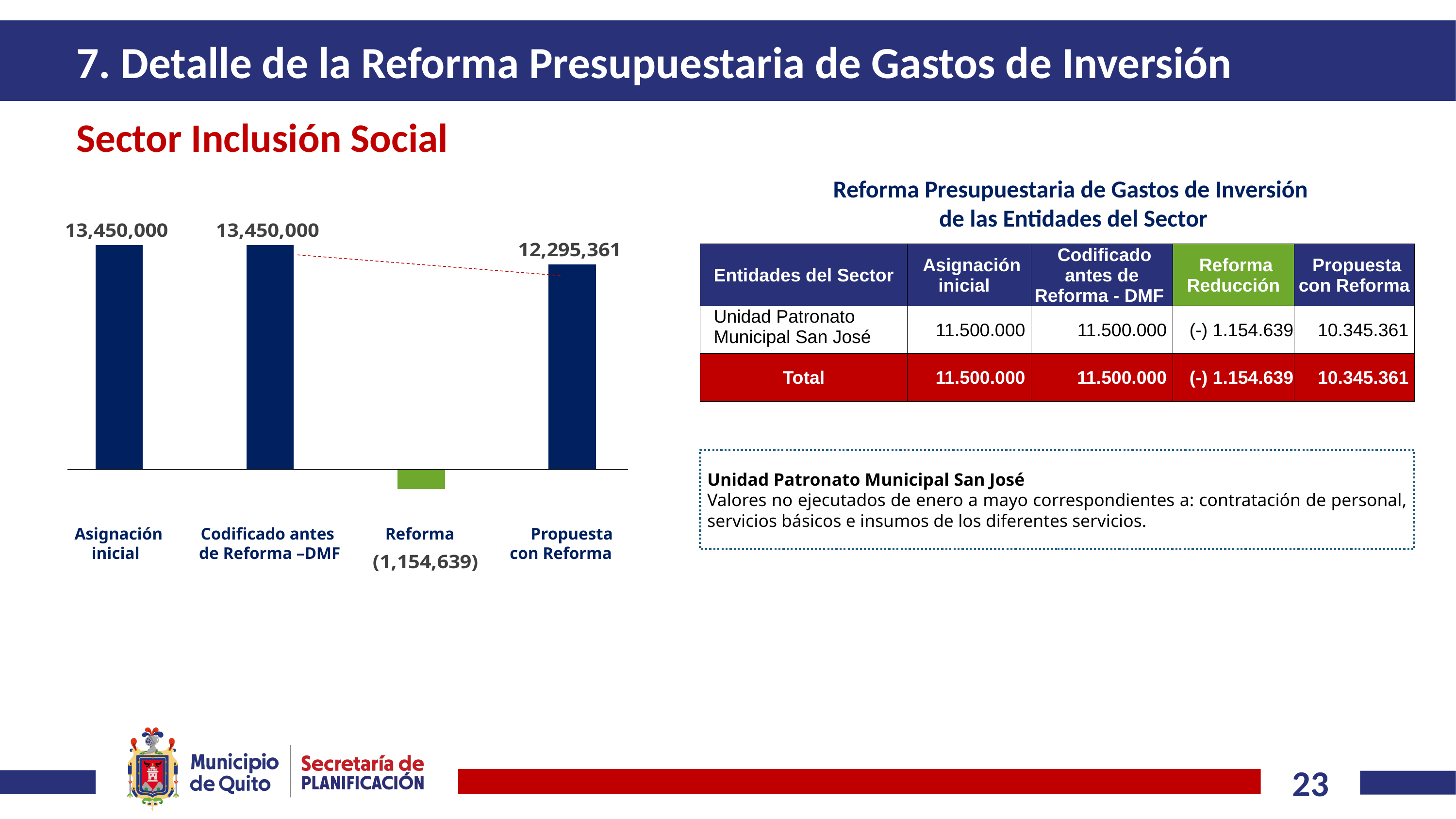
How many categories are plotted in the chart? 4 What value is labelled for the Reforma bar in the chart? (1,154,639) Which bar in the chart is coloured green? Reforma Which category has the lowest value in the chart? Reforma Which sector heading appears above the chart? Sector Inclusión Social What is the value of the Asignación inicial bar in the chart? 13,450,000 Does the value rise or fall from Codificado antes de Reforma –DMF to Propuesta con Reforma in the chart? Fall Which is larger in the chart: Codificado antes de Reforma –DMF or Propuesta con Reforma? Codificado antes de Reforma –DMF What kind of chart is shown on the slide? Bar chart What is the value of the Propuesta con Reforma bar in the chart? 12,295,361 What is the value shown for Codificado antes de Reforma –DMF in the chart? 13,450,000 What is the difference between the Codificado antes de Reforma –DMF value and the Propuesta con Reforma value in the chart? 1,154,639